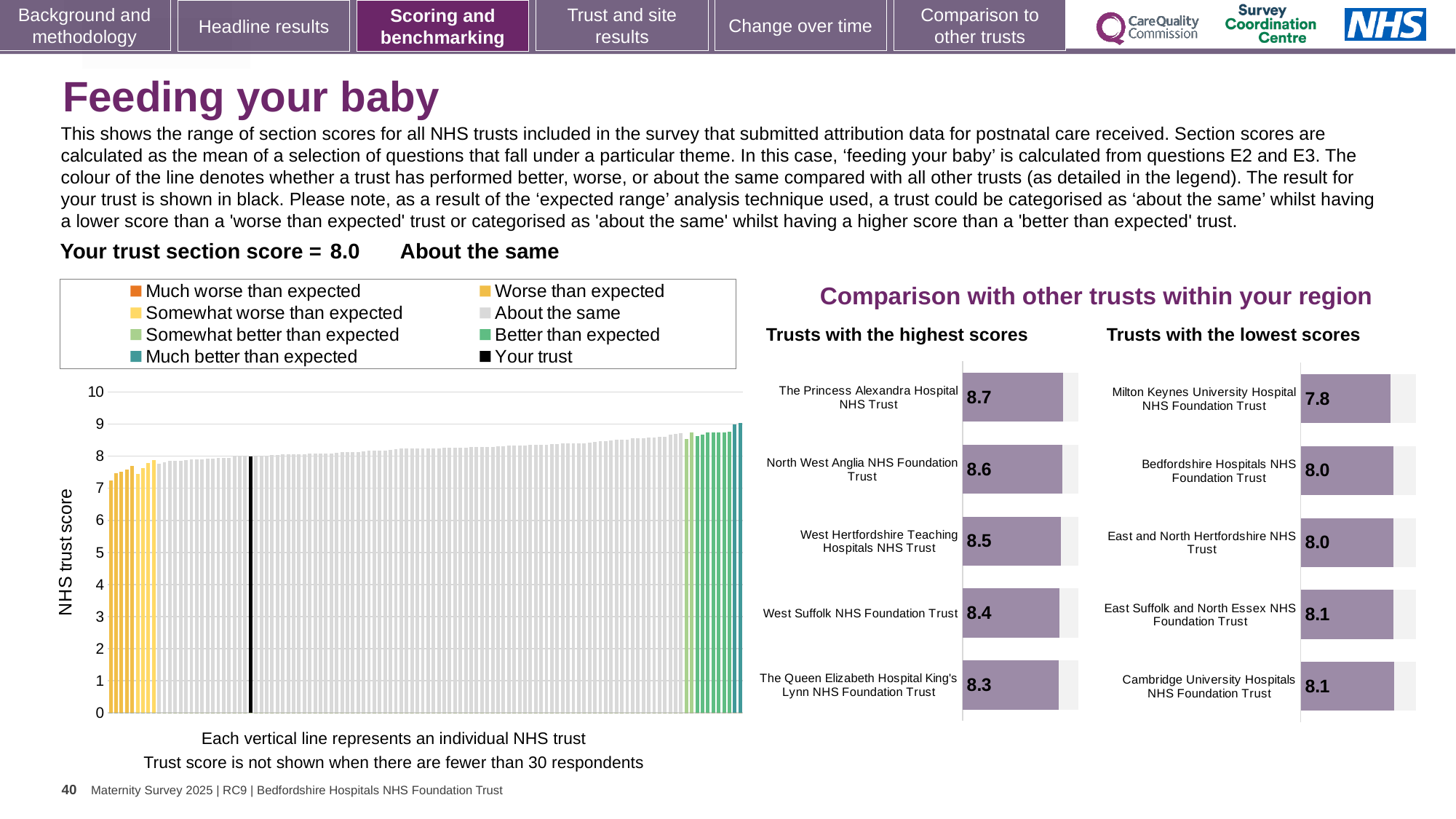
In the large chart on the left showing NHS trust scores, is the value of the leftmost bar greater or less than 8? less In the 'Trusts with the highest scores' chart, what is the score for The Princess Alexandra Hospital NHS Trust? 8.7 In the 'Trusts with the lowest scores' chart, which has the larger score: Bedfordshire Hospitals NHS Foundation Trust or Cambridge University Hospitals NHS Foundation Trust? Cambridge University Hospitals NHS Foundation Trust In the 'Trusts with the highest scores' chart, what is the difference between the scores of The Princess Alexandra Hospital NHS Trust and West Suffolk NHS Foundation Trust? 0.3 In the large chart on the left showing NHS trust scores, what kind of chart is it? Bar chart In the 'Trusts with the lowest scores' chart, which trust has the lowest score? Milton Keynes University Hospital NHS Foundation Trust In the 'Trusts with the highest scores' chart, which trust has the lowest score? The Queen Elizabeth Hospital King's Lynn NHS Foundation Trust In the 'Trusts with the lowest scores' chart, what is the difference between the scores of East Suffolk and North Essex NHS Foundation Trust and Milton Keynes University Hospital NHS Foundation Trust? 0.3 In the 'Trusts with the lowest scores' chart, what is the score for Milton Keynes University Hospital NHS Foundation Trust? 7.8 In the large chart on the left showing NHS trust scores, do the values rise or fall from left to right along the x axis? Rise How many entries does the legend above the large chart on the left list? 8 In the 'Trusts with the highest scores' chart, how many trusts are shown? 5